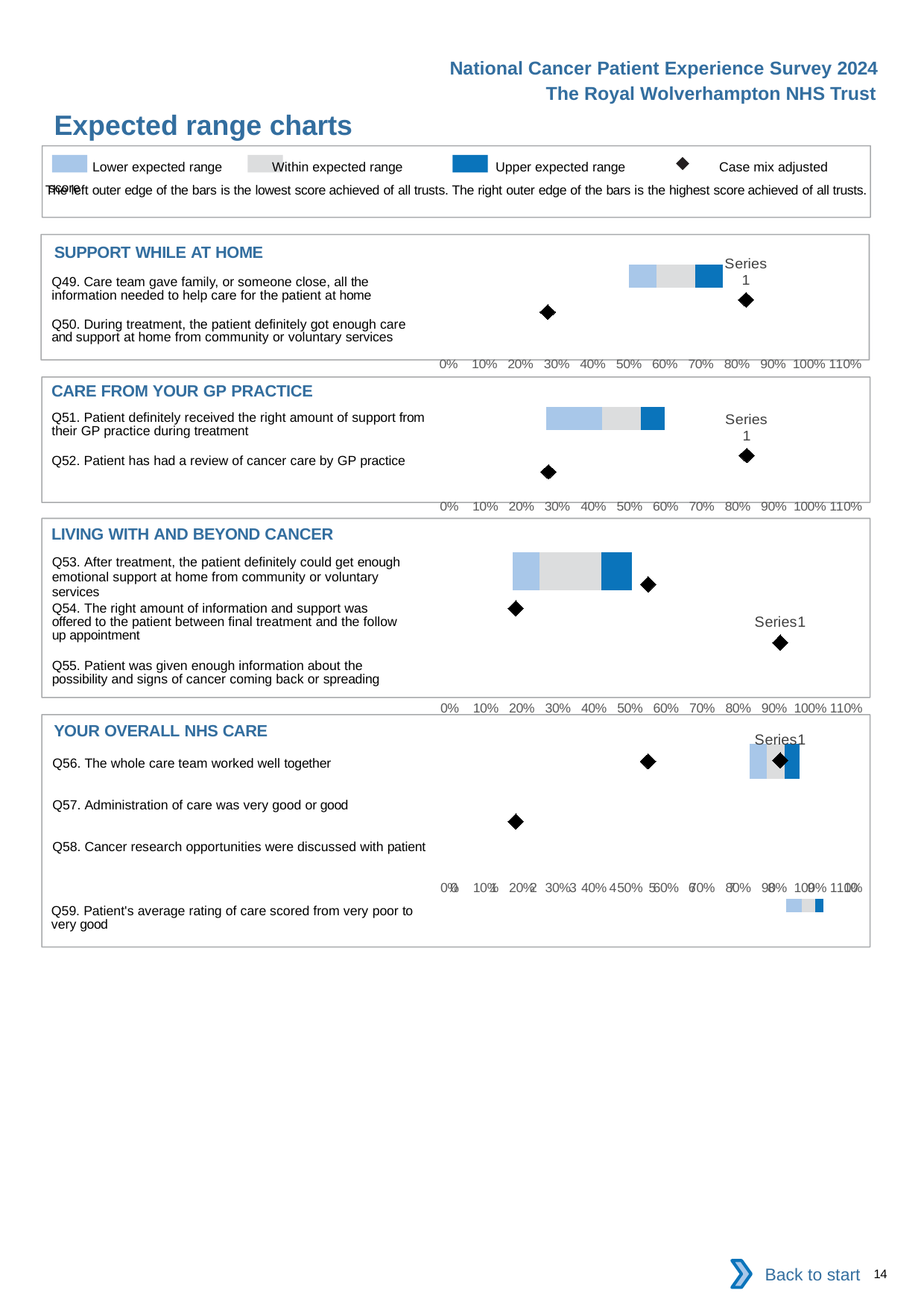
In the YOUR OVERALL NHS CARE chart, is the leftmost diamond marker greater or less than 30%? less Which legend entry is shown in dark blue? Upper expected range In the LIVING WITH AND BEYOND CANCER chart, is the rightmost diamond marker greater or less than 80%? greater What kind of chart is used in the SUPPORT WHILE AT HOME section? bar chart How many questions are listed in the YOUR OVERALL NHS CARE chart? 4 In the SUPPORT WHILE AT HOME chart, is the leftmost diamond marker greater or less than 40%? less How many questions are listed in the LIVING WITH AND BEYOND CANCER chart? 3 How many entries does the legend at the top of the slide list? 4 What is the highest value shown on the x axis of the CARE FROM YOUR GP PRACTICE chart? 110% How many diamond markers are plotted in the SUPPORT WHILE AT HOME chart? 2